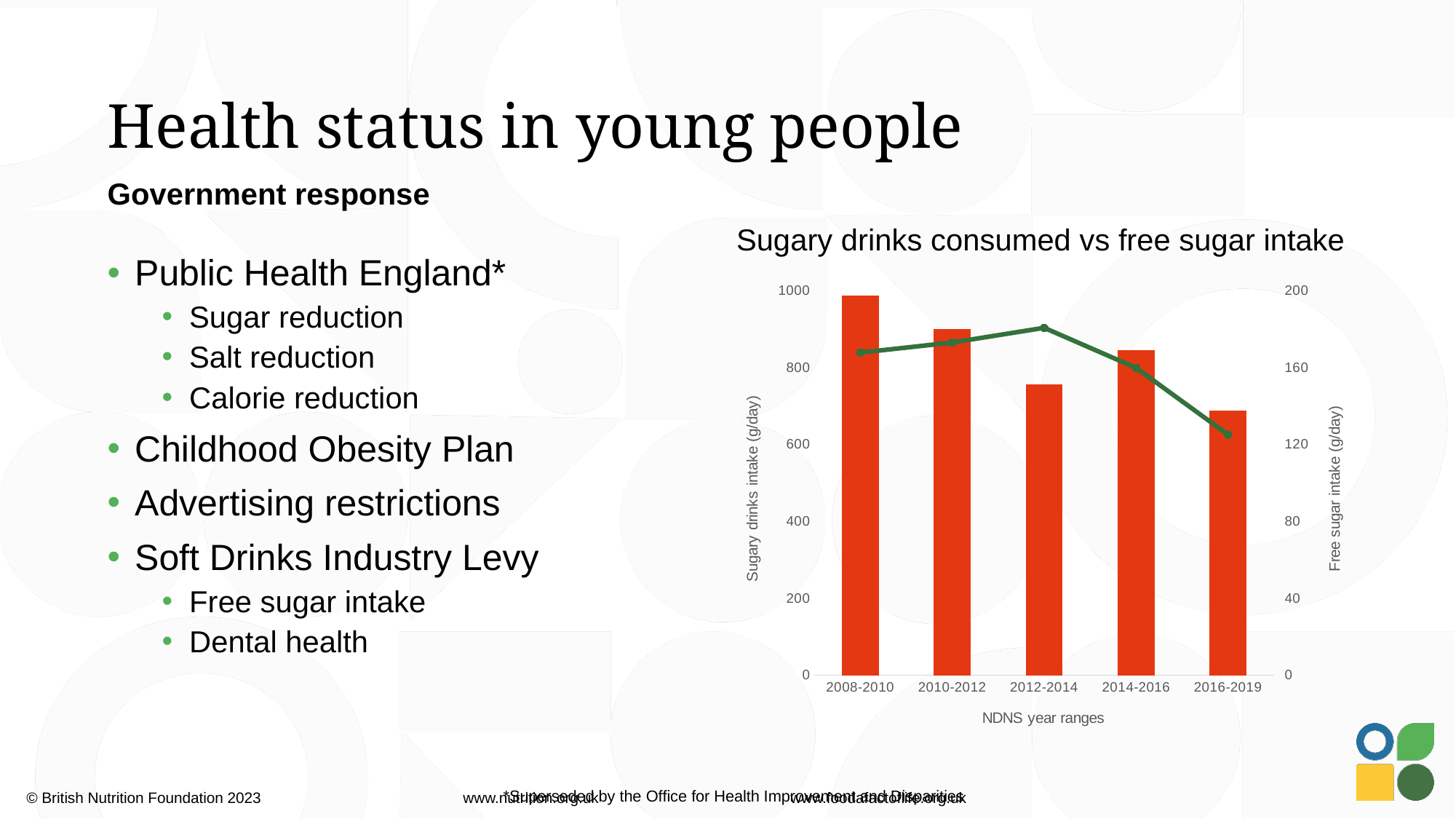
How many NDNS year ranges are shown on the x axis of the chart? 5 What is the title of the chart? Sugary drinks consumed vs free sugar intake Is the sugary drinks intake bar for 2008-2010 greater or less than 800? greater What is the label of the left vertical axis? Sugary drinks intake (g/day) Which NDNS year range has the highest point on the free sugar intake line? 2012-2014 Which NDNS year range has the highest bar for sugary drinks intake? 2008-2010 Which has the taller sugary drinks intake bar, 2012-2014 or 2014-2016? 2014-2016 What kind of chart is shown on the slide? A combined bar and line chart Is the sugary drinks intake bar for 2016-2019 greater or less than 800? less Is the free sugar intake value for 2016-2019 greater or less than 160 on the right axis? less Which NDNS year range has the lowest point on the free sugar intake line? 2016-2019 Which NDNS year range has the lowest bar for sugary drinks intake? 2016-2019